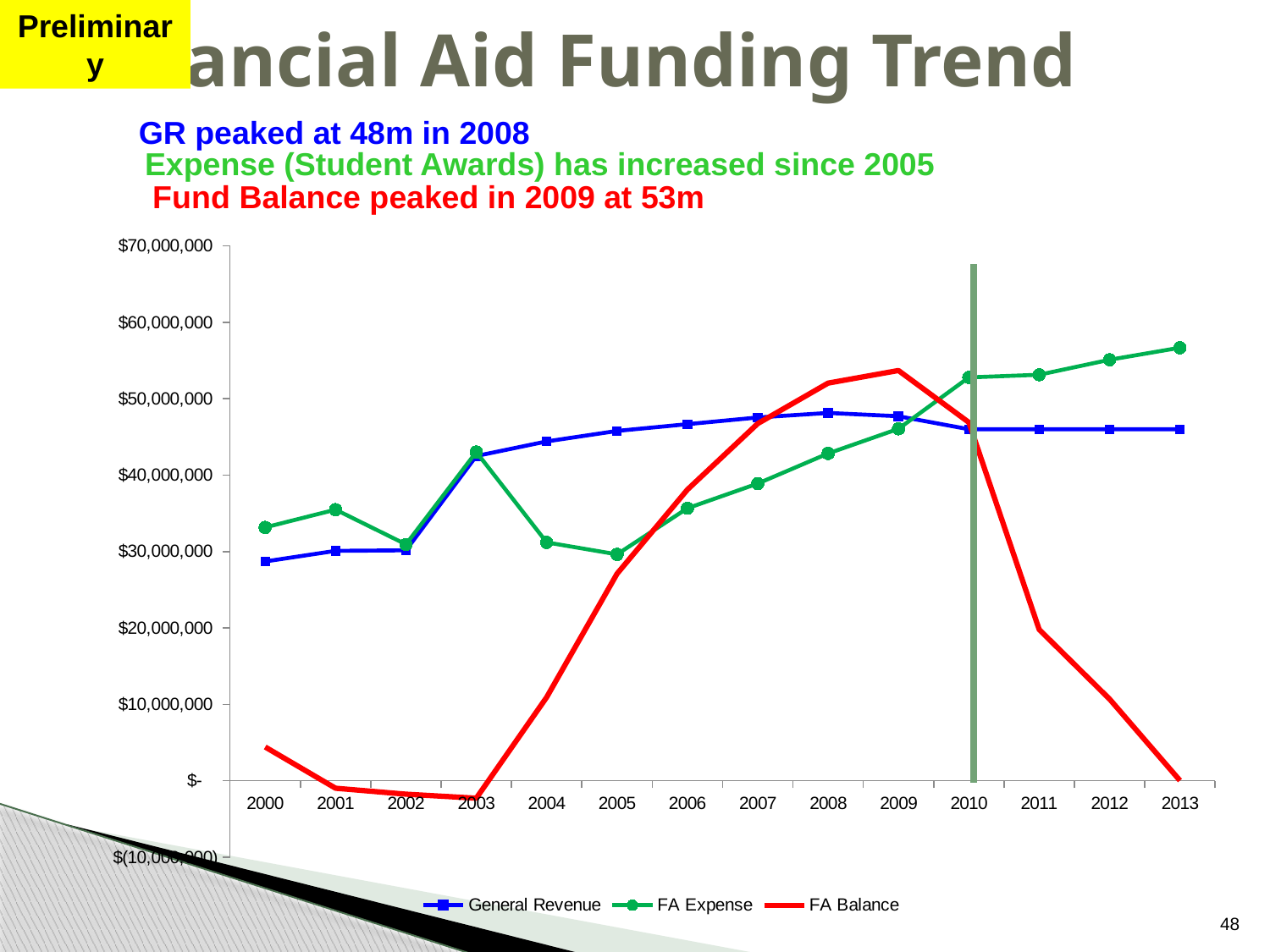
In 2004, which is larger: FA Expense or FA Balance? FA Expense In which year does FA Balance reach its highest value? 2009 Is the General Revenue value for 2008 greater or less than $50,000,000? less Which series is drawn in red? FA Balance Does the FA Balance line rise or fall from 2009 to 2013? fall In which year does FA Expense reach its highest value? 2013 How many years are shown on the x axis? 14 Is the FA Balance value for 2005 greater or less than $30,000,000? less How many series does the legend list? 3 What are the three series named in the legend? General Revenue, FA Expense, FA Balance What kind of chart is shown on the slide? line chart Is the FA Expense value for 2013 greater or less than $50,000,000? greater